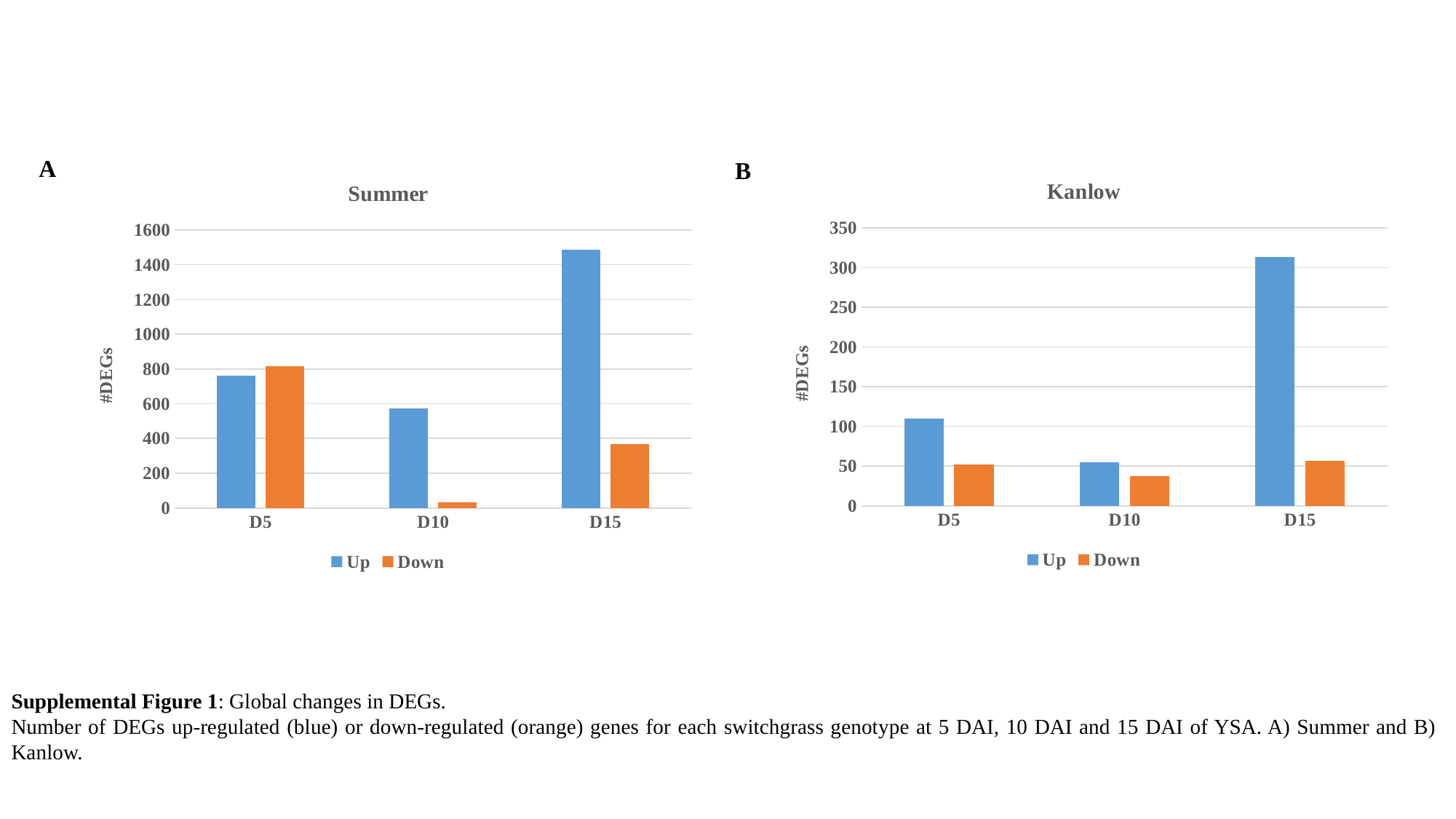
In the Summer chart, at which time point is the Down series lowest? D10 What kind of chart is the Summer chart? bar chart In the Summer chart, at which time point is the Up series highest? D15 In the Kanlow chart, is the Up value at D15 greater or less than 250? greater In the Summer chart, is the Down value at D10 greater or less than 200? less In the Kanlow chart, at which time point is the Down series lowest? D10 In the Kanlow chart, at which time point is the Up series highest? D15 In the Summer chart, which is larger at D10, Up or Down? Up How many series does the legend of the Kanlow chart list? 2 How many time points are shown on the x axis of the Summer chart? 3 In the Summer chart, is the Up value at D15 greater or less than 1400? greater In the Kanlow chart, which is larger at D5, Up or Down? Up